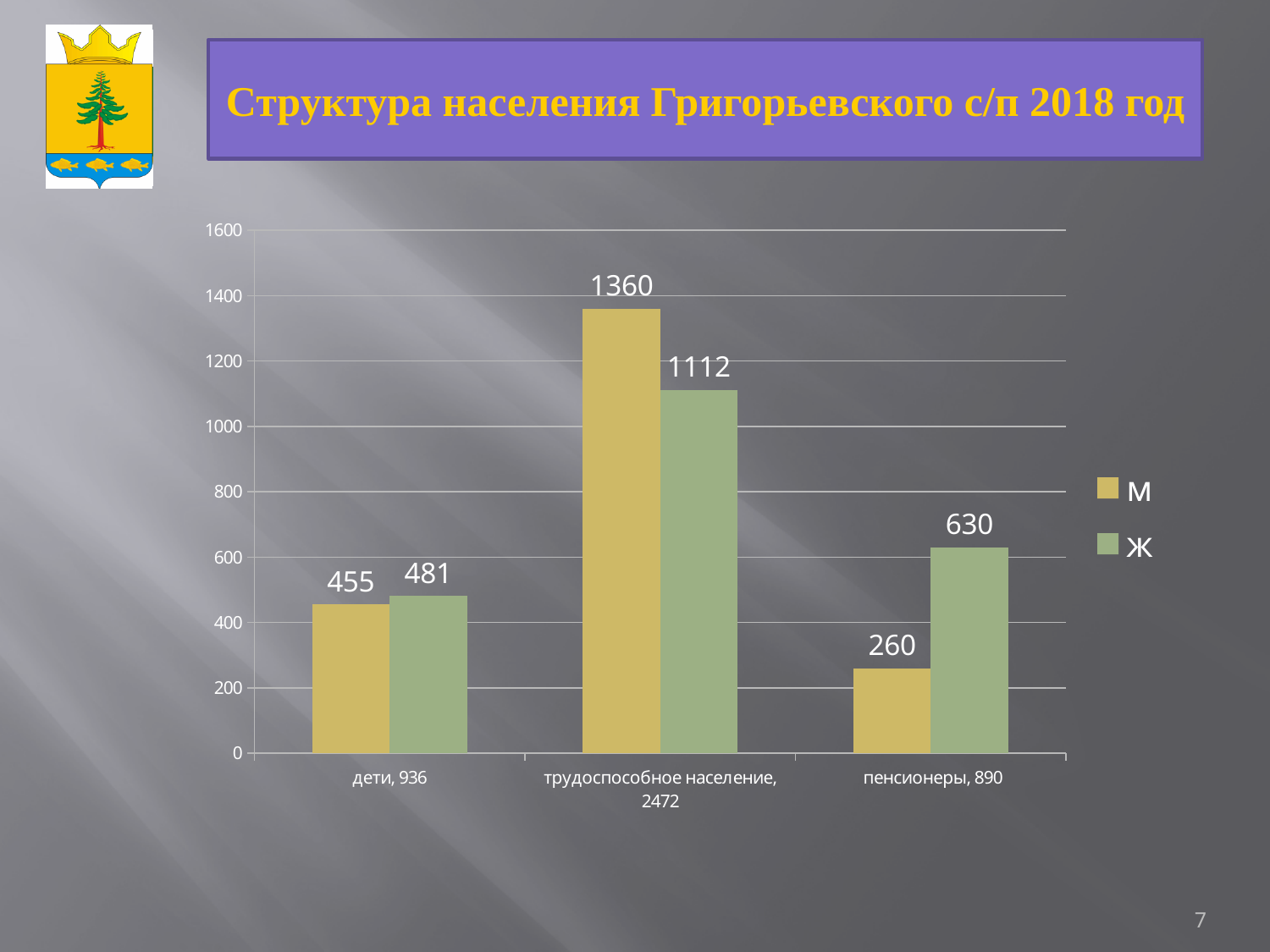
What is the title of the slide? Структура населения Григорьевского с/п 2018 год What is the value for Ж (women) in the category 'пенсионеры, 890'? 630 How many categories are shown on the x axis? 3 What is the value for Ж (women) in the category 'трудоспособное население, 2472'? 1112 Which category has the highest value for the М series? трудоспособное население, 2472 What kind of chart is shown on the slide? bar chart Which category has the lowest value for the М series? пенсионеры, 890 What is the difference between the М and Ж values in the category 'трудоспособное население, 2472'? 248 What is the value for М (men) in the category 'дети, 936'? 455 How many series does the legend list? 2 In the category 'дети, 936', which series has the larger value, М or Ж? Ж What is the difference between the Ж and М values in the category 'пенсионеры, 890'? 370